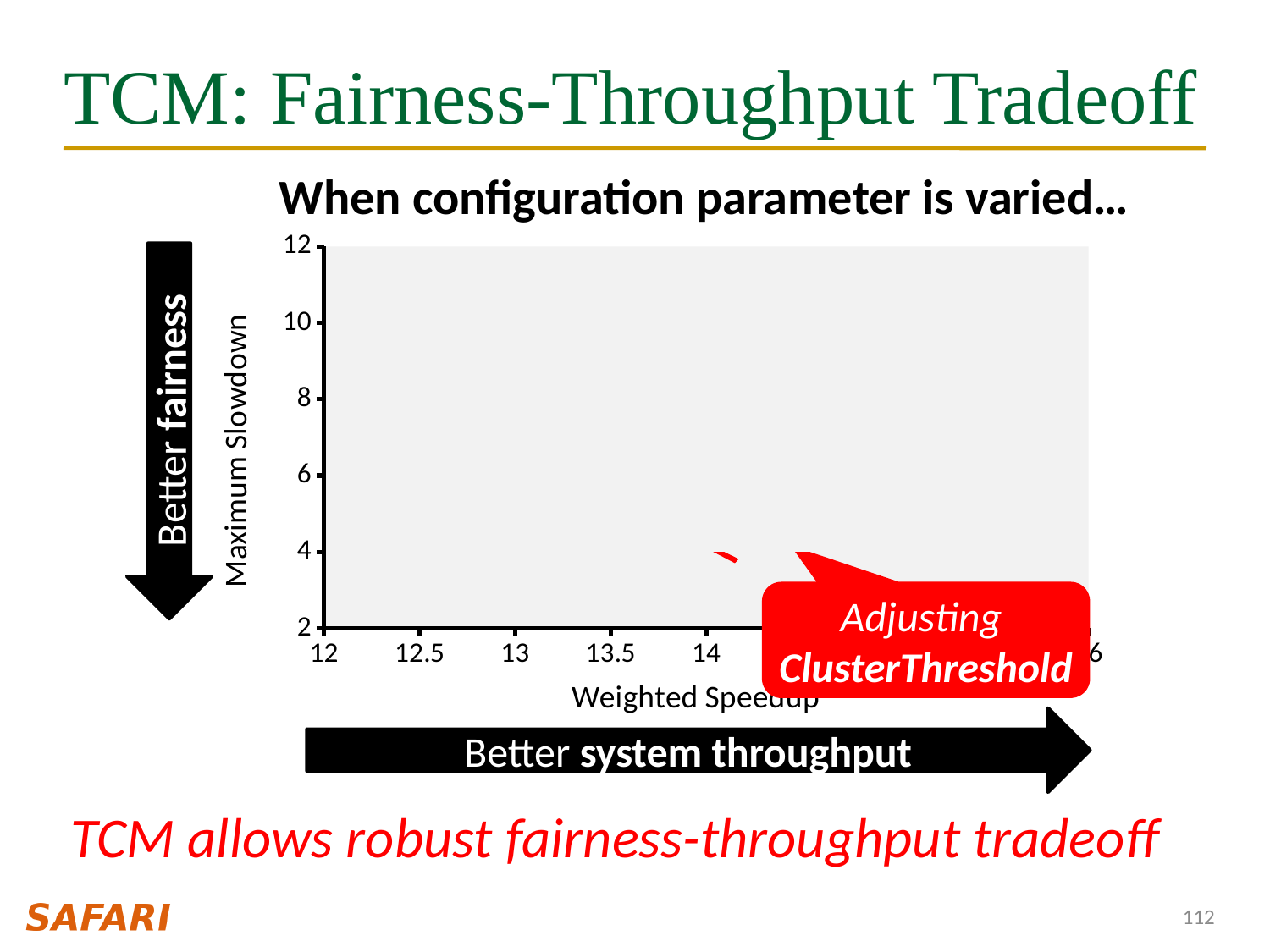
What is the title of the horizontal axis of the chart? Weighted Speedup What is the title of the vertical axis of the chart? Maximum Slowdown Is the Maximum Slowdown of the visible red data point greater or less than 6? less Is the Weighted Speedup of the visible red data point greater or less than 13.5? greater